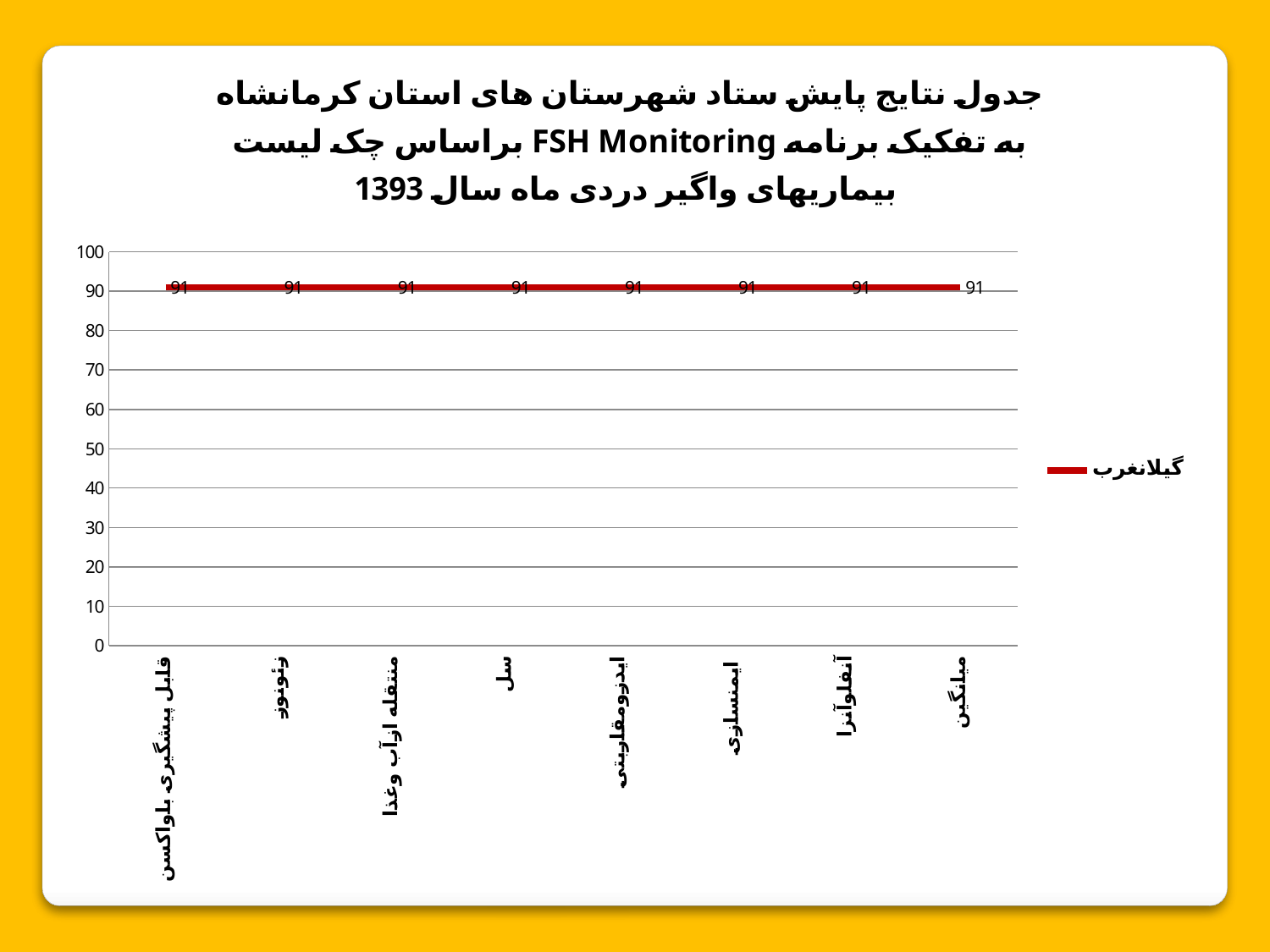
What is the value for سل? 91 Is the value for ایدز و مقاربتی greater or less than 80? greater What is the value for آنفلوآنزا? 91 How many categories are plotted on the x axis? 8 Do the values rise, fall, or stay flat across the categories on the x axis? stay flat What is the name of the series shown in the legend? گیلانغرب What is the value for زئونوز? 91 What type of chart is shown on the slide? line chart What is the difference between the values for ایمنسازی and سل? 0 What colour is the line for گیلانغرب? red How many series does the legend list? 1 What is the value for میانگین? 91